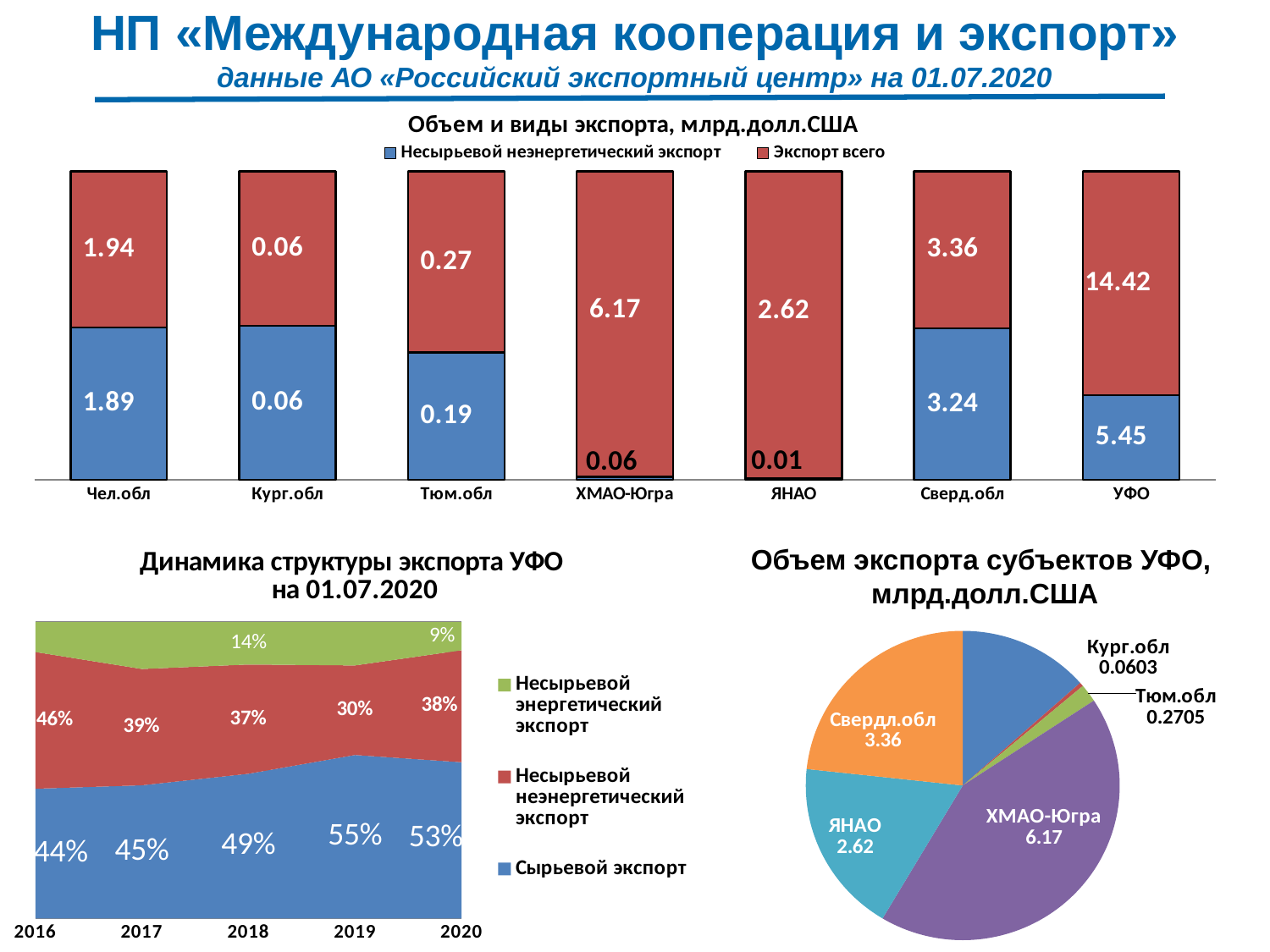
In the top chart 'Объем и виды экспорта, млрд.долл.США', what is the value of 'Несырьевой неэнергетический экспорт' for Сверд.обл? 3.24 In the bottom-left chart 'Динамика структуры экспорта УФО', what is the share of 'Сырьевой экспорт' in 2019? 55% In the top chart 'Объем и виды экспорта, млрд.долл.США', which is larger: 'Экспорт всего' for ХМАО-Югра or for ЯНАО? ХМАО-Югра In the top chart 'Объем и виды экспорта, млрд.долл.США', what is the difference between 'Экспорт всего' and 'Несырьевой неэнергетический экспорт' for УФО? 8.97 In the bottom-left chart 'Динамика структуры экспорта УФО', what is the share of 'Несырьевой энергетический экспорт' in 2020? 9% How many regions are shown on the x axis of the top chart 'Объем и виды экспорта, млрд.долл.США'? 7 In the bottom-right pie chart 'Объем экспорта субъектов УФО', what is the value for ЯНАО? 2.62 In the bottom-right pie chart 'Объем экспорта субъектов УФО', which labeled region has the largest slice? ХМАО-Югра In the top chart 'Объем и виды экспорта, млрд.долл.США', what is the value of 'Экспорт всего' for УФО? 14.42 How many series does the legend of the top chart 'Объем и виды экспорта, млрд.долл.США' list? 2 In the top chart 'Объем и виды экспорта, млрд.долл.США', which region has the highest 'Экспорт всего' value? УФО What kind of chart is the bottom-left chart 'Динамика структуры экспорта УФО'? Area chart